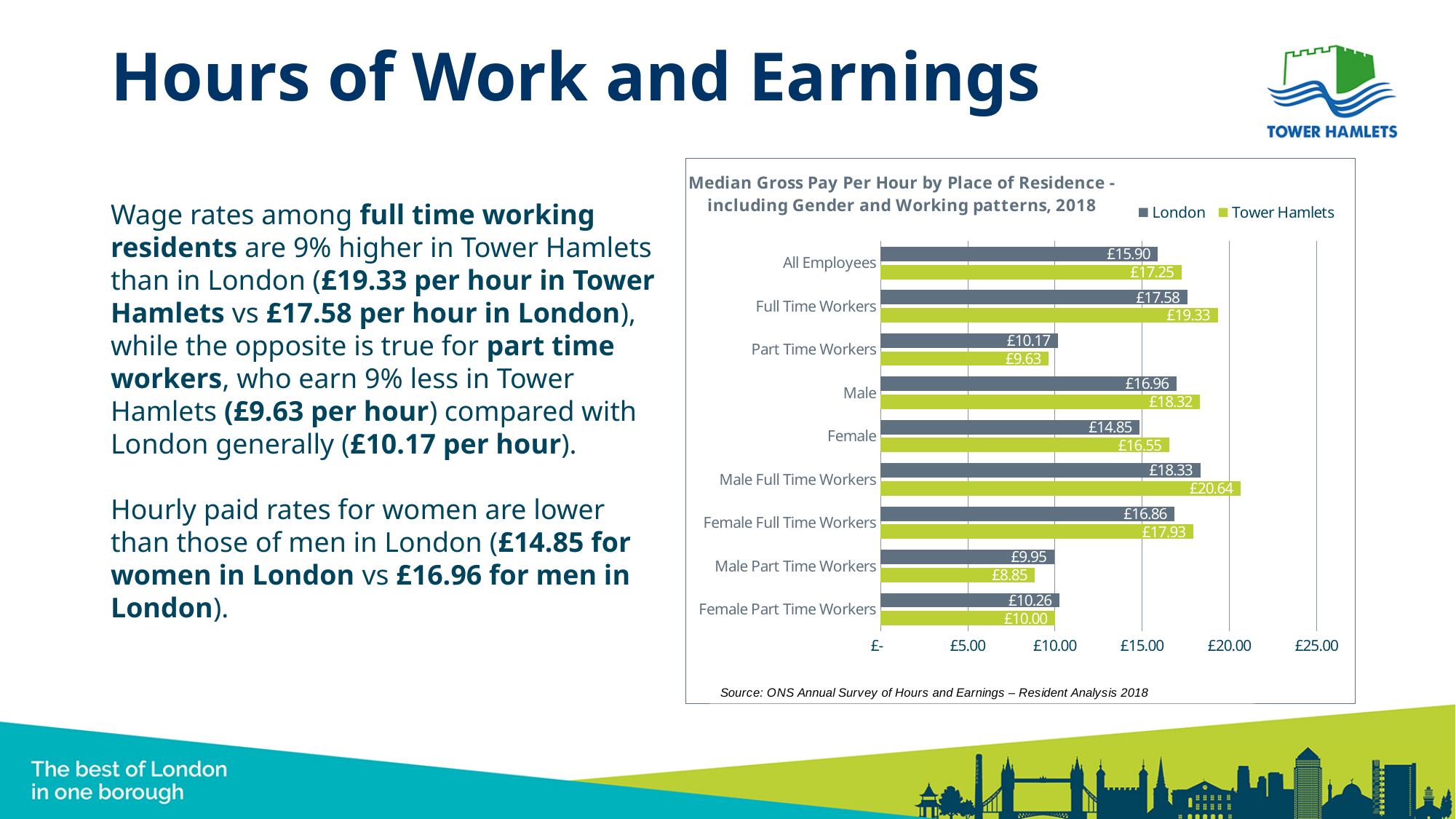
What is the difference between the Tower Hamlets and London values for All Employees? £1.35 Which category has the lowest median gross pay per hour for London? Male Part Time Workers What kind of chart is shown on the slide? Bar chart Which is larger for Part Time Workers: the London value or the Tower Hamlets value? London Is the value for Male Full Time Workers in Tower Hamlets greater or less than £20.00? greater How many categories are shown on the chart? 9 What is the median gross pay per hour for Female workers in London? £14.85 Which category has the highest median gross pay per hour for Tower Hamlets? Male Full Time Workers Which colour represents Tower Hamlets in the chart? Green How many series does the legend list? 2 What is the median gross pay per hour for Full Time Workers in Tower Hamlets? £19.33 What is the median gross pay per hour for Male Part Time Workers in Tower Hamlets? £8.85